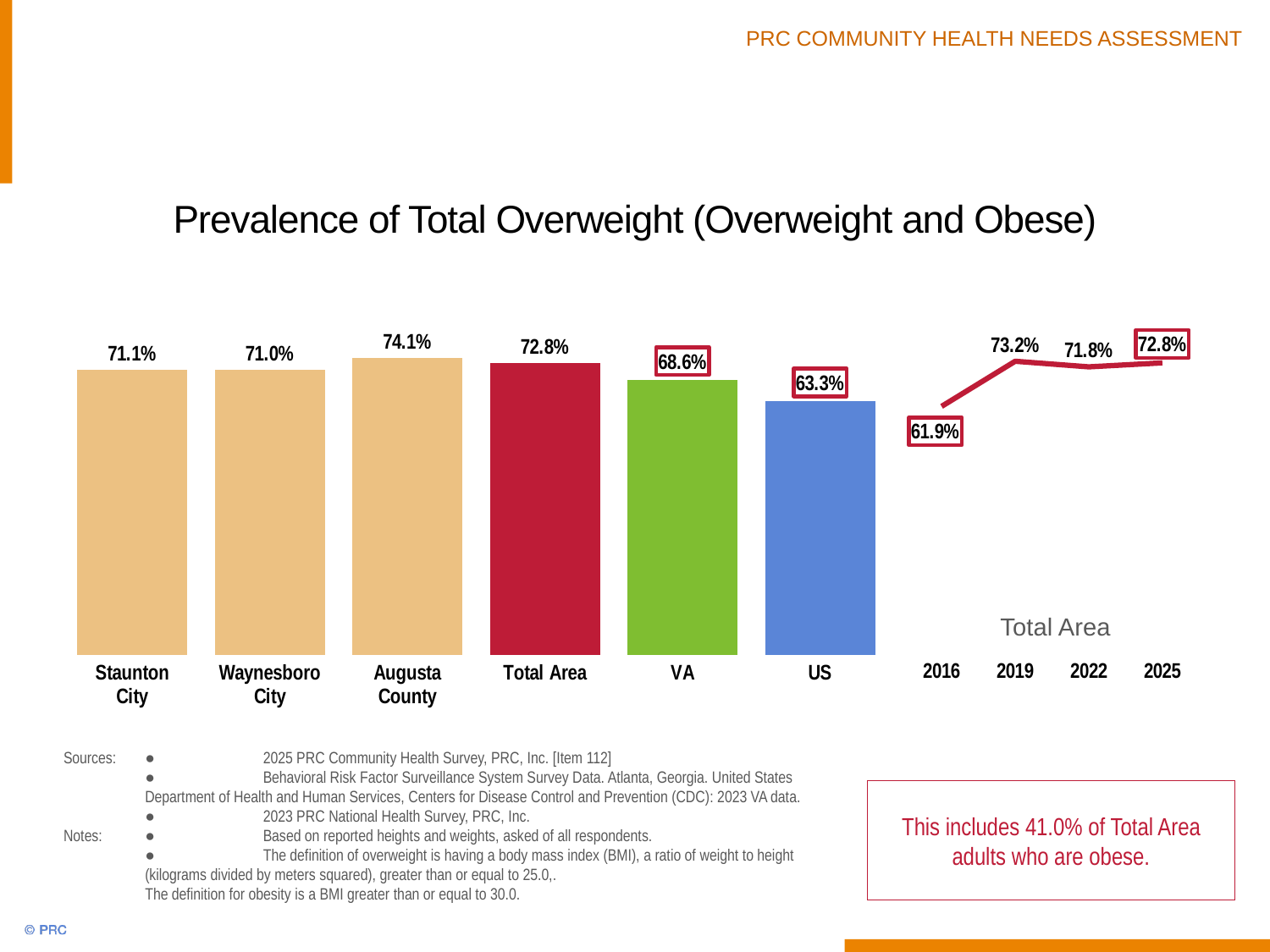
In the bar chart on the left, what is the value for US? 63.3% In the bar chart on the left, what is the difference between the Total Area value and the VA value? 4.2% In the Total Area line chart on the right, what is the value for 2016? 61.9% In the bar chart on the left, which category has the highest value? Augusta County In the Total Area line chart on the right, what is the difference between the 2025 value and the 2016 value? 10.9% In the bar chart on the left, what is the value for Augusta County? 74.1% How many categories are shown in the bar chart on the left? 6 In the bar chart on the left, which is larger, the value for Staunton City or the value for VA? Staunton City In the bar chart on the left, which category has the lowest value? US What is the title of the slide's chart? Prevalence of Total Overweight (Overweight and Obese) What kind of chart is the chart on the left? bar chart In the Total Area line chart on the right, which year has the highest value? 2019